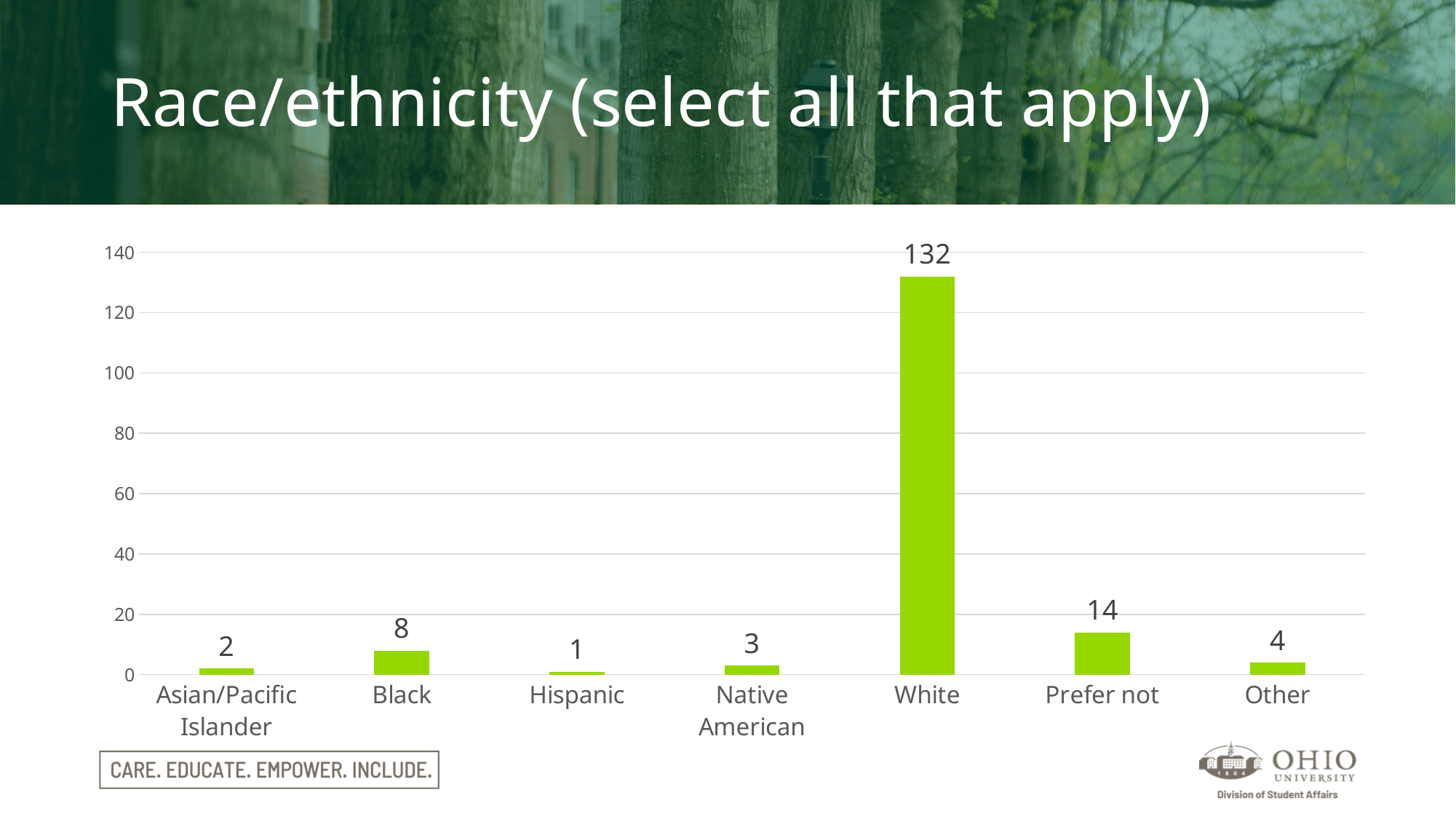
What is the value for Native American? 3 What is the difference between the values for White and Prefer not? 118 What is the value for White? 132 How many categories are shown on the x axis? 7 What is the value for Asian/Pacific Islander? 2 What kind of chart is shown on the slide? bar chart Which is larger, the value for Black or the value for Other? Black What is the value for Prefer not? 14 Which category has the highest value? White What is the difference between the values for Black and Other? 4 Which category has the lowest value? Hispanic Is the value for White greater or less than 120? greater